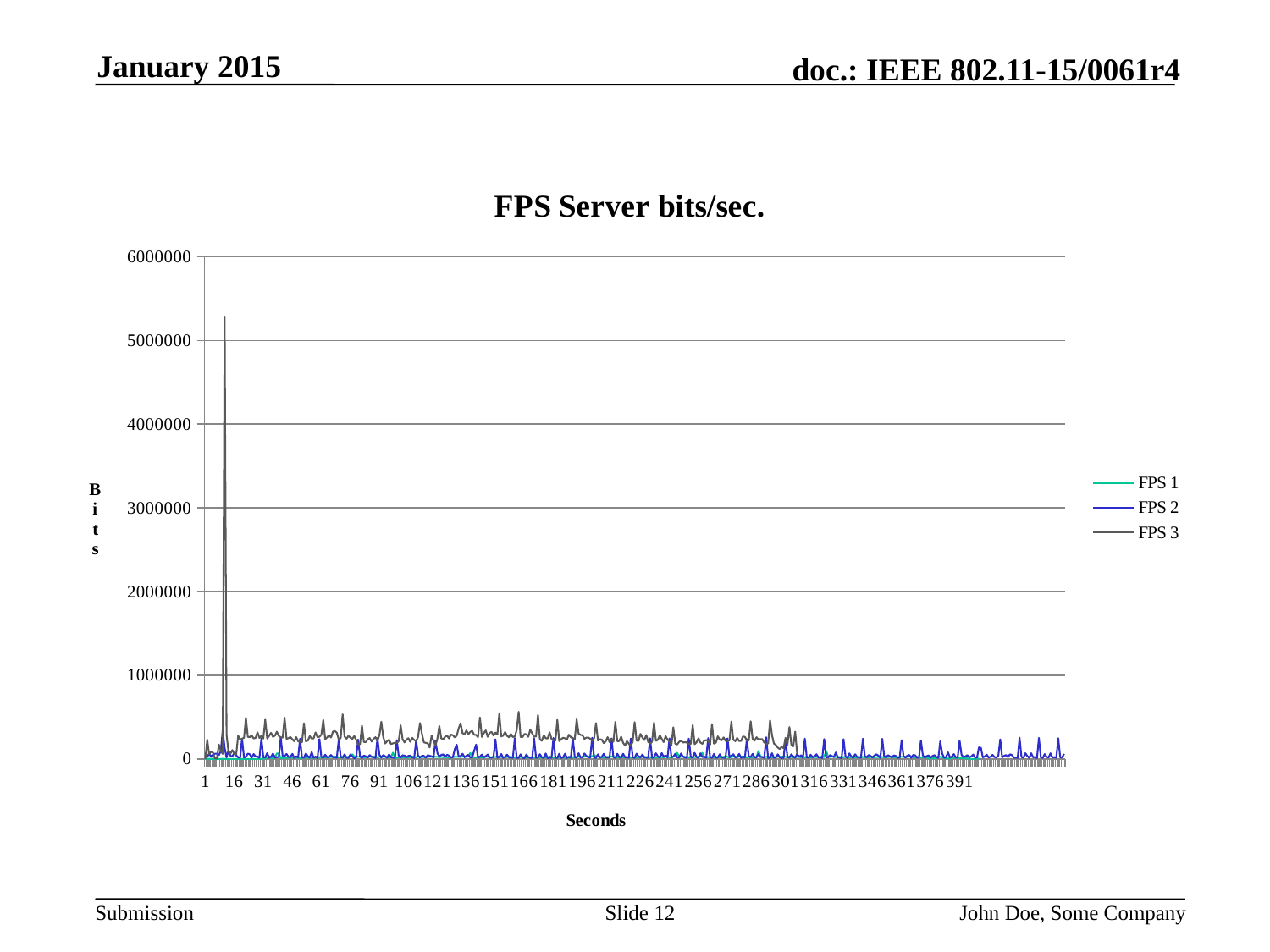
Is the highest peak of the FPS 3 series greater or less than 6000000? less What kind of chart is shown on the slide? line chart What are the names of the series listed in the legend? FPS 1, FPS 2, FPS 3 Which series reaches the highest peak value on the chart? FPS 3 What is the first category label shown on the x axis? 1 What is the label of the x axis? Seconds What is the last category label shown on the x axis? 391 Is the highest peak of the FPS 3 series greater or less than 5000000? greater How many series does the legend list? 3 Is the highest peak of the FPS 2 series greater or less than 1000000? less What is the highest value shown on the y axis? 6000000 What is the title of the chart? FPS Server bits/sec.